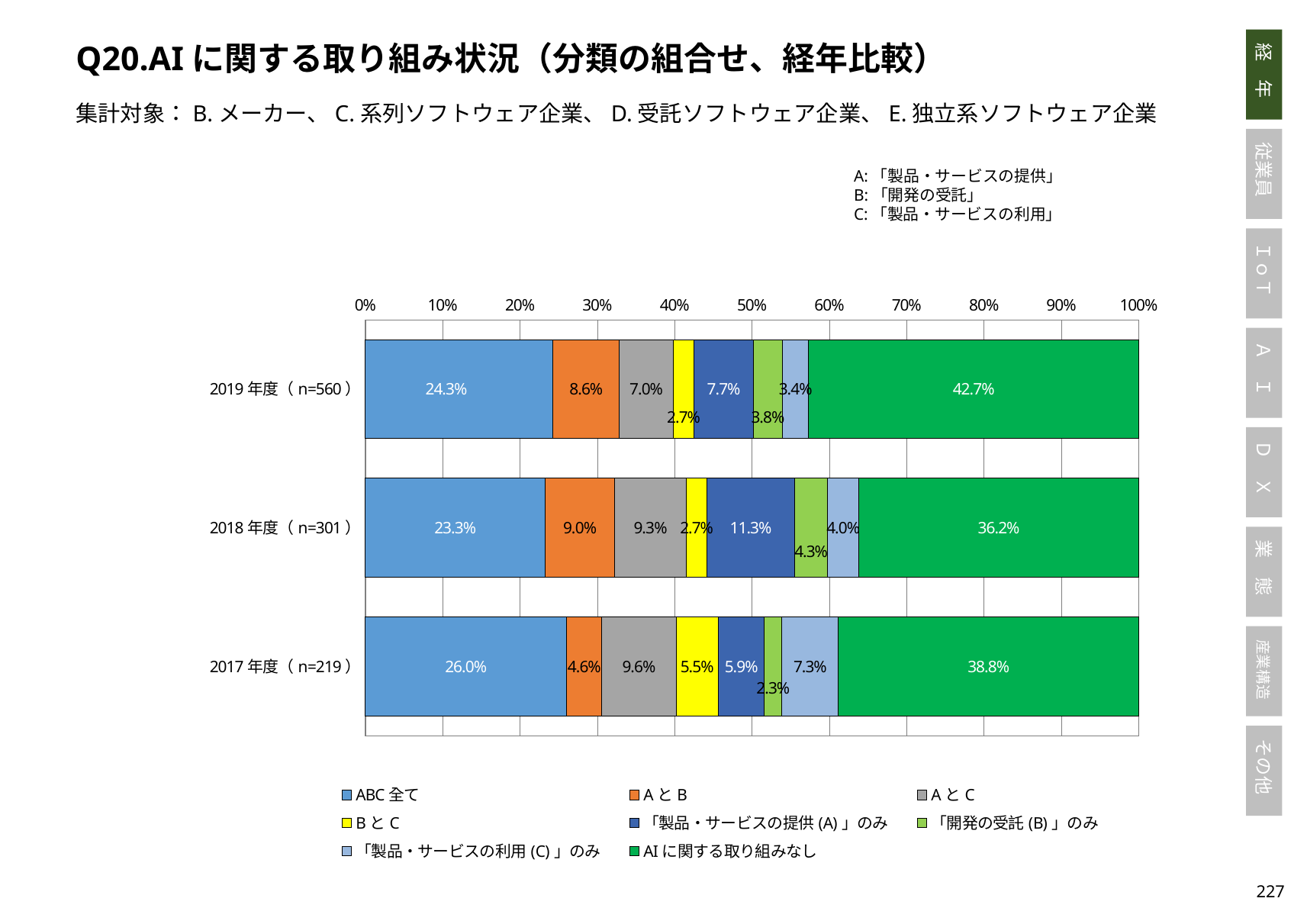
What is the difference between the 「AI に関する取り組みなし」 values for 2019 年度 and 2018 年度? 6.5% Which fiscal year has the highest value for 「AI に関する取り組みなし」? 2019 年度 (n=560) Which is larger: 「製品・サービスの提供 (A)」のみ for 2018 年度 or for 2017 年度? 2018 年度 (11.3%) What is the value of 「AI に関する取り組みなし」 for 2018 年度 (n=301)? 36.2% What is the value of 「ABC 全て」 for 2019 年度 (n=560)? 24.3% Does the value of 「ABC 全て」 rise or fall from 2017 年度 to 2018 年度? Fall What is the sample size (n) shown for 2019 年度? n=560 What is the value of 「製品・サービスの利用 (C)」のみ for 2017 年度 (n=219)? 7.3% Which fiscal year has the lowest value for 「A と B」? 2017 年度 (n=219) What type of chart is shown on the slide? Stacked bar chart How many fiscal-year categories are plotted on the chart? 3 How many series does the legend list? 8